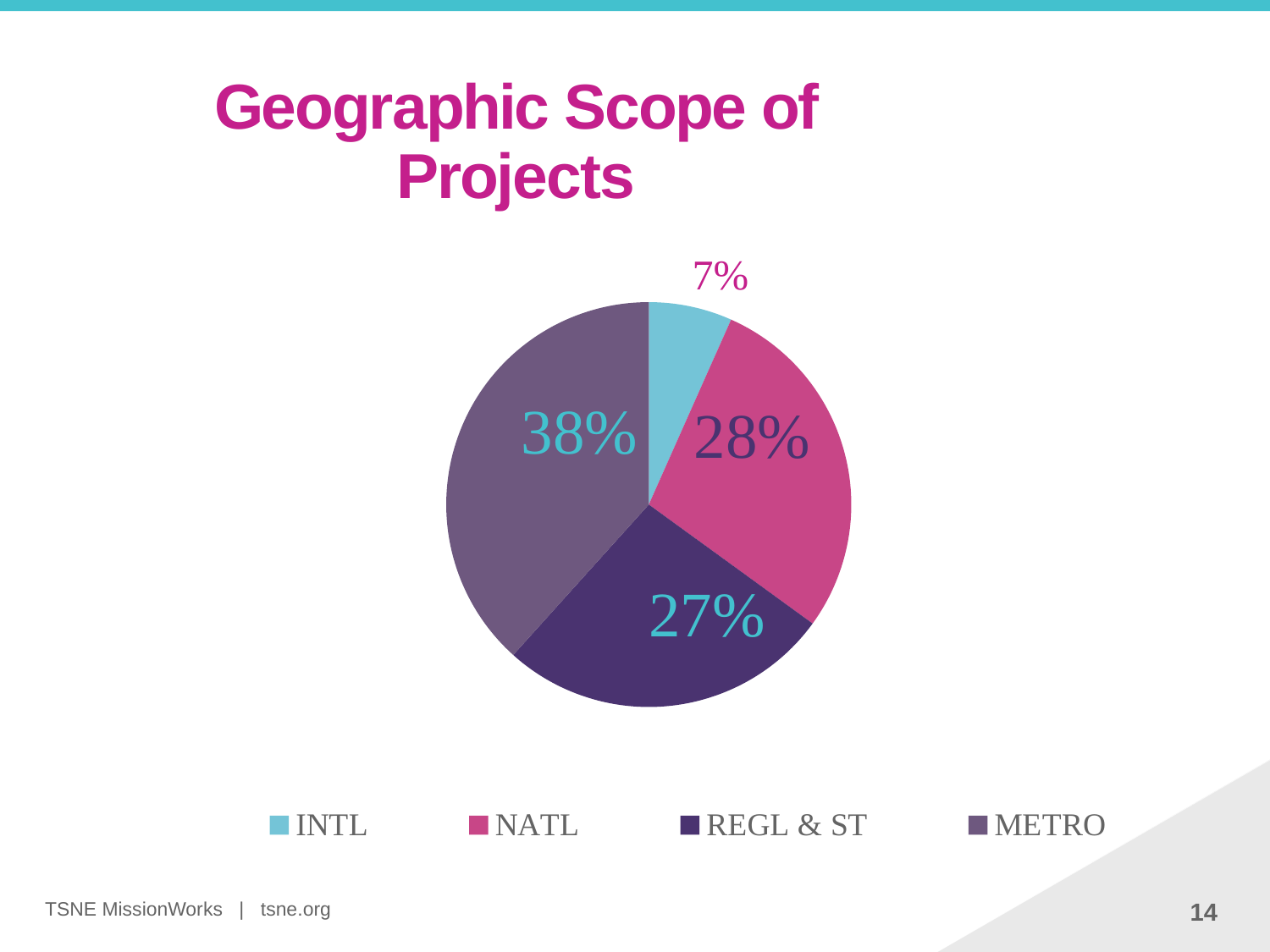
What is the title of the slide containing the pie chart? Geographic Scope of Projects Which is larger, the share for NATL or the share for REGL & ST? NATL Which category has the largest share of the pie? METRO How many slices does the pie chart have? 4 What share of projects is METRO? 38% Which category has the smallest share of the pie? INTL What kind of chart is shown on the slide? pie chart What is the difference in percentage points between METRO and INTL? 31 What share of projects is INTL? 7% How many entries does the legend list? 4 What share of projects is NATL? 28% What share of projects is REGL & ST? 27%